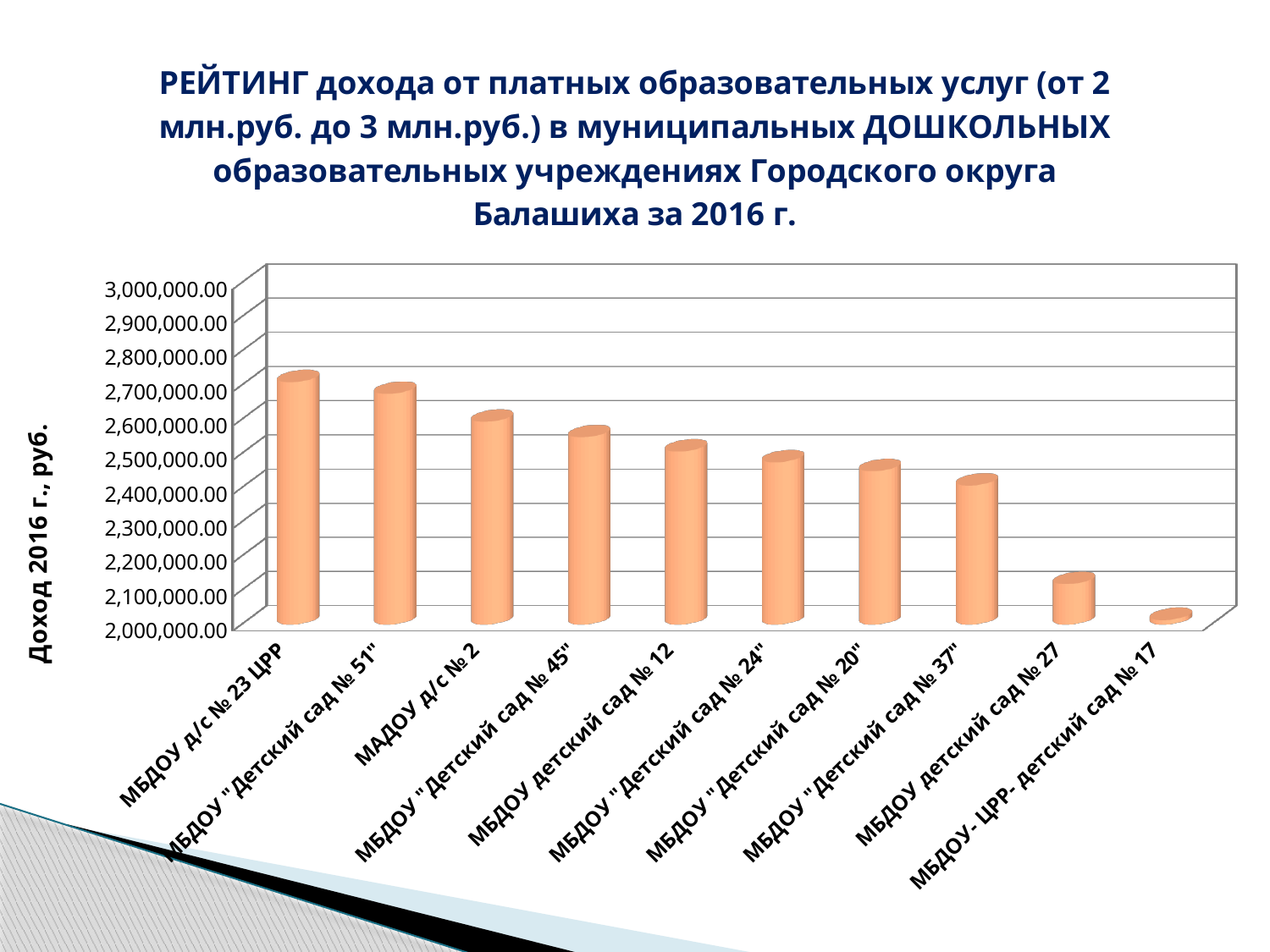
Which has the larger value: МБДОУ "Детский сад № 51" or МБДОУ детский сад № 27? МБДОУ "Детский сад № 51" What kind of chart is shown on the slide? bar chart What is the title of the vertical axis? Доход 2016 г., руб. Which institution has the highest income on the chart? МБДОУ д/с № 23 ЦРР Which institution has the lowest income on the chart? МБДОУ- ЦРР- детский сад № 17 Is the value for МАДОУ д/с № 2 greater or less than 2,500,000.00? greater Do the values rise or fall from left to right along the x axis? fall Is the value for МБДОУ детский сад № 27 greater or less than 2,200,000.00? less Is the value for МБДОУ- ЦРР- детский сад № 17 greater or less than 2,100,000.00? less How many institutions (categories) are shown on the chart? 10